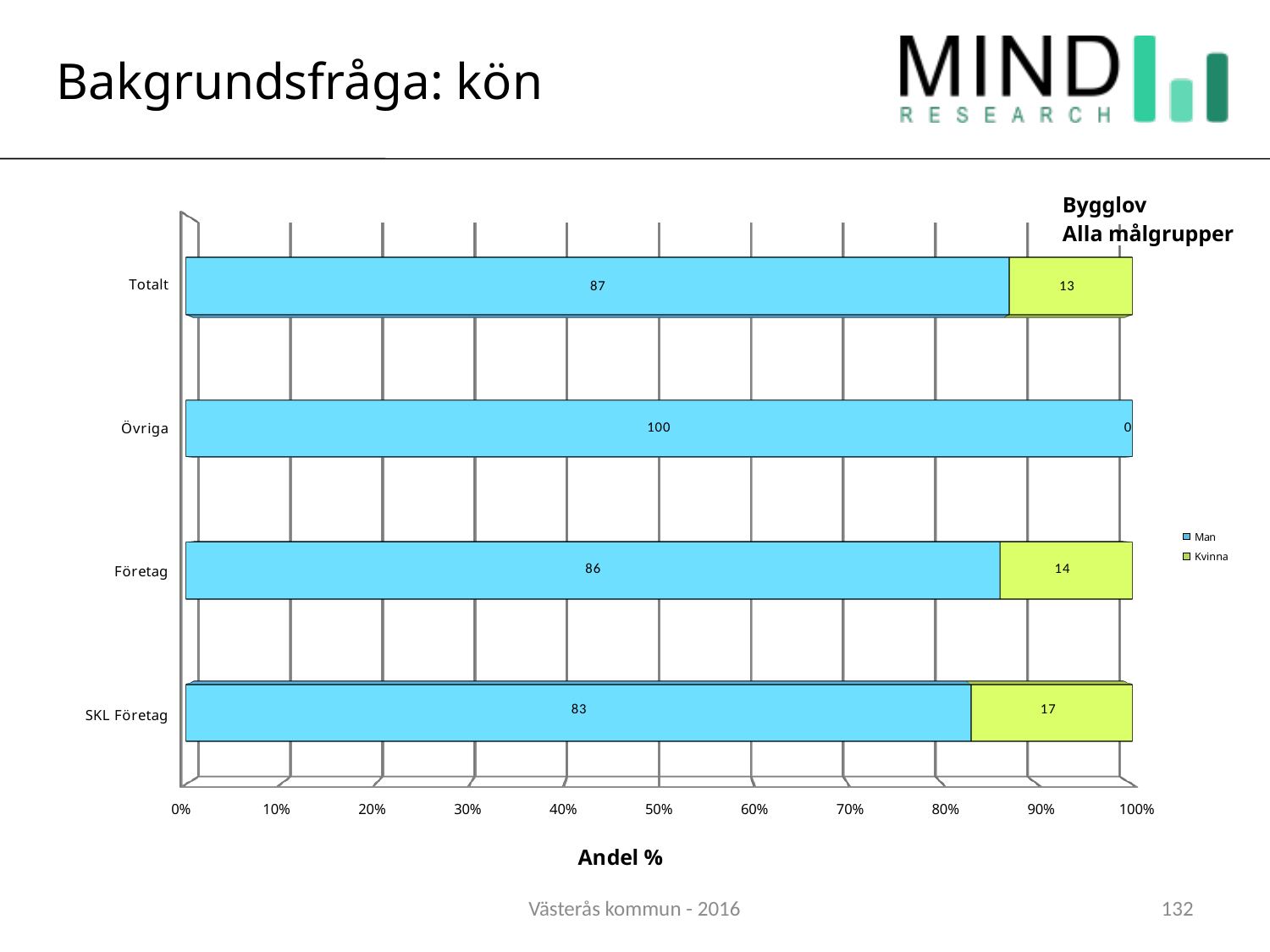
What is the value for Kvinna in the SKL Företag category? 17 What kind of chart is shown on the slide? Stacked bar chart What is the difference between the Man values for Totalt and SKL Företag? 4 How many categories are shown on the y axis? 4 What is the value for Man in the Övriga category? 100 What is the value for Man in the Totalt category? 87 What is the value for Kvinna in the Företag category? 14 What is the label of the x axis? Andel % Which category has the lowest value for Kvinna? Övriga How many series does the legend list? 2 Which category has the highest value for Man? Övriga Which is larger, the Kvinna value for Företag or for SKL Företag? SKL Företag